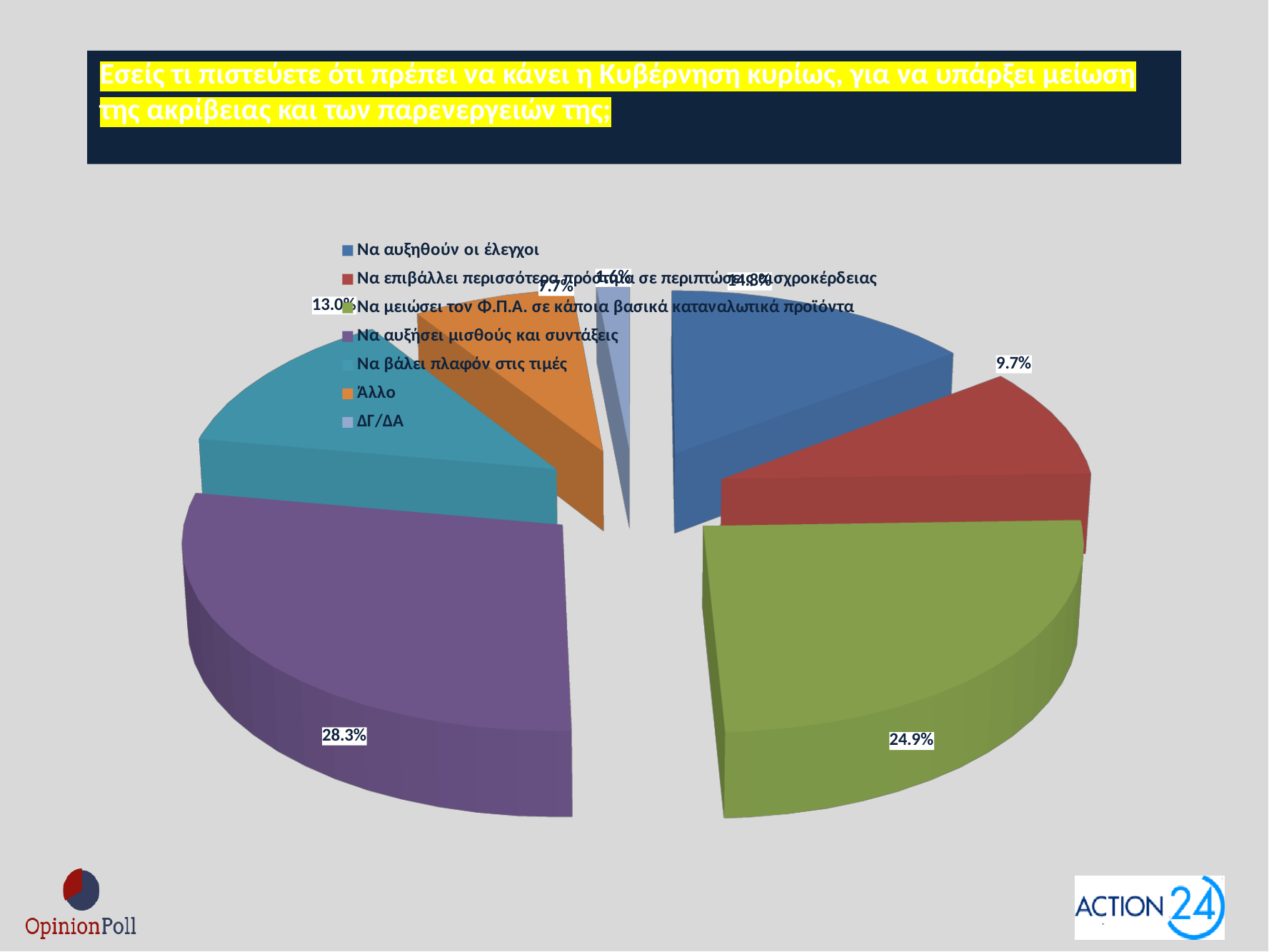
What kind of chart is shown on the slide? Pie chart Which category has the smallest share of the pie? ΔΓ/ΔΑ Which category has the largest share of the pie? Να αυξήσει μισθούς και συντάξεις What percentage is shown for 'Να αυξήσει μισθούς και συντάξεις'? 28.3% What percentage is shown for 'Να βάλει πλαφόν στις τιμές'? 13.0% What percentage is shown for 'Άλλο'? 7.7% What percentage is shown for 'Να επιβάλλει περισσότερα πρόστιμα σε περιπτώσεις αισχροκέρδειας'? 9.7% What percentage is shown for 'Να μειώσει τον Φ.Π.Α. σε κάποια βασικά καταναλωτικά προϊόντα'? 24.9% What is the difference in percentage points between 'Να αυξήσει μισθούς και συντάξεις' and 'Να μειώσει τον Φ.Π.Α. σε κάποια βασικά καταναλωτικά προϊόντα'? 3.4 percentage points Which is larger: the share for 'Να βάλει πλαφόν στις τιμές' or the share for 'Να επιβάλλει περισσότερα πρόστιμα σε περιπτώσεις αισχροκέρδειας'? Να βάλει πλαφόν στις τιμές What colour represents 'Άλλο' in the pie chart? Orange How many categories does the legend list? 7